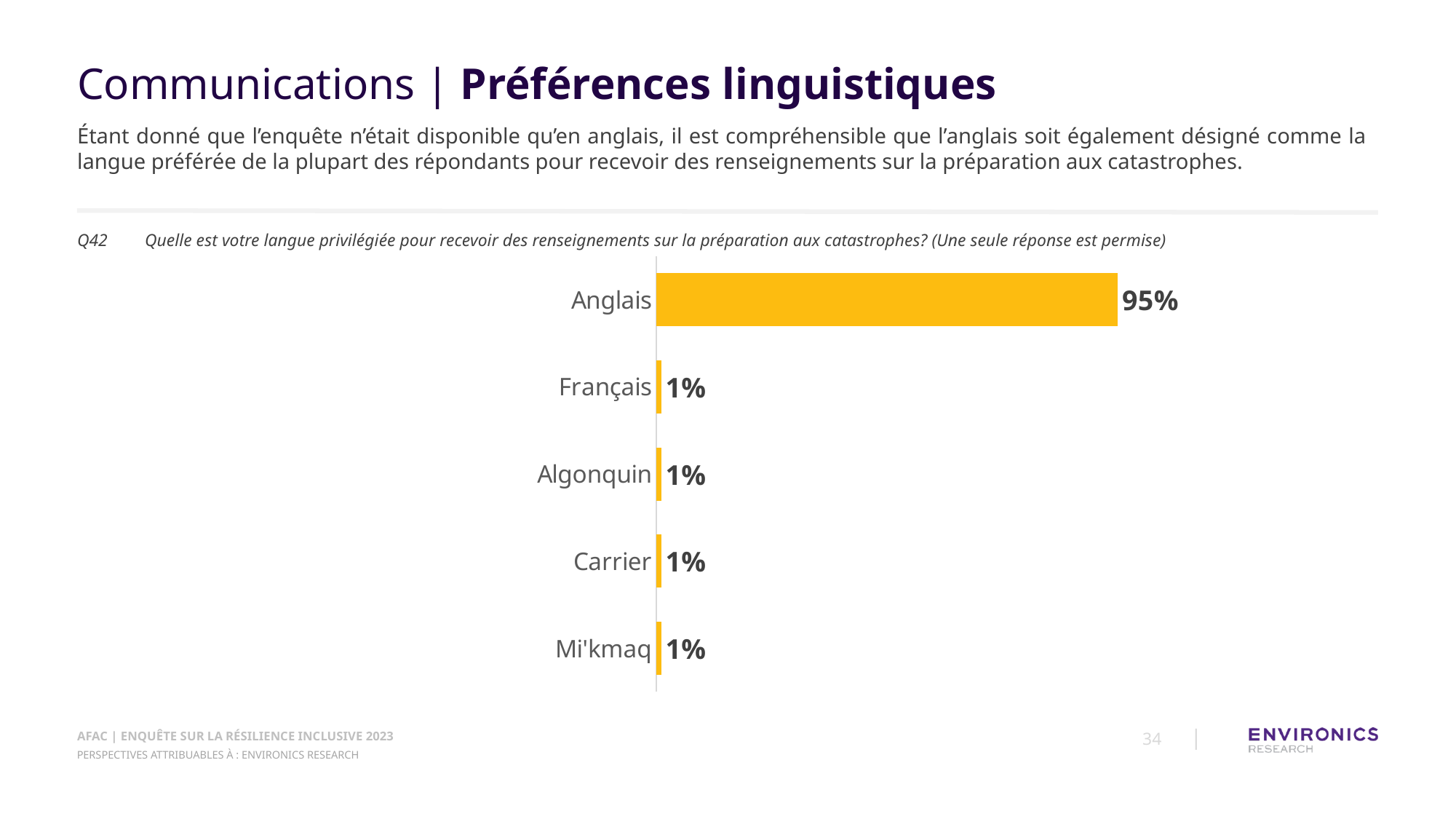
What is the difference between the values for Anglais and Français? 94% Which is larger, the value for Anglais or the value for Carrier? Anglais Which category is listed first (at the top) of the chart? Anglais What is the value for Anglais? 95% Which category has the highest value? Anglais What kind of chart is shown on the slide? Bar chart How many categories have a value of 1%? 4 How many categories are shown in the chart? 5 What colour are the bars in the chart? Yellow What is the value for Français? 1% What is the value for Mi'kmaq? 1% What is the value for Algonquin? 1%